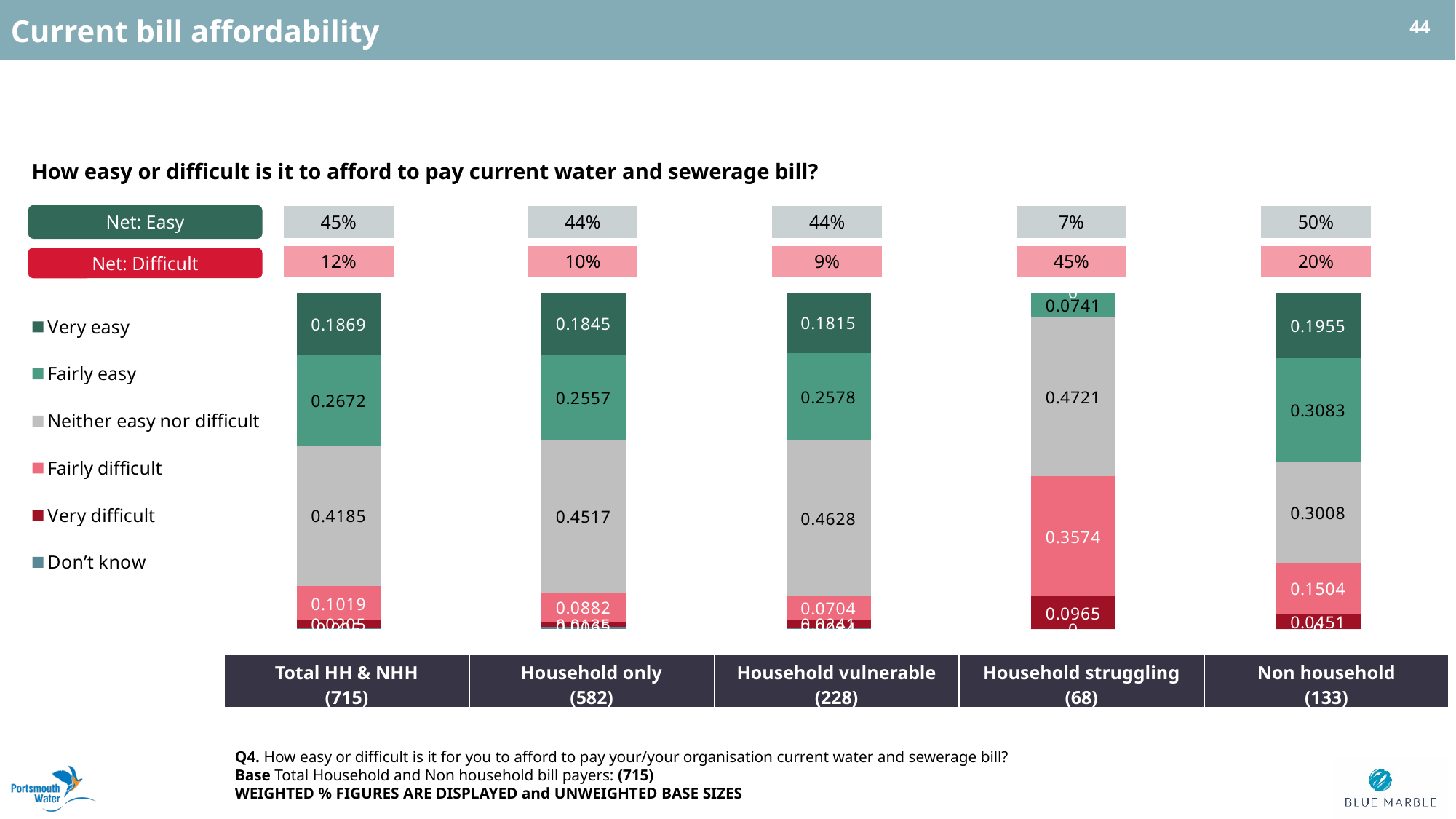
How many series does the legend list? 6 What is the difference between the Net: Difficult figures for Household struggling and Total HH & NHH? 33% Which group has the lowest Net: Difficult figure? Household vulnerable Which group has the highest Net: Easy figure? Non household What is the value for Very easy for Non household? 0.1955 What is the value for Fairly difficult for Household struggling? 0.3574 How many groups are shown along the x axis? 5 What is the value for Neither easy nor difficult for Total HH & NHH? 0.4185 What is the value for Fairly easy for Household vulnerable? 0.2578 What is the Net: Easy figure for Household struggling? 7% What kind of chart is shown? Stacked bar chart Which is larger, the Fairly difficult value for Household struggling or for Non household? Household struggling